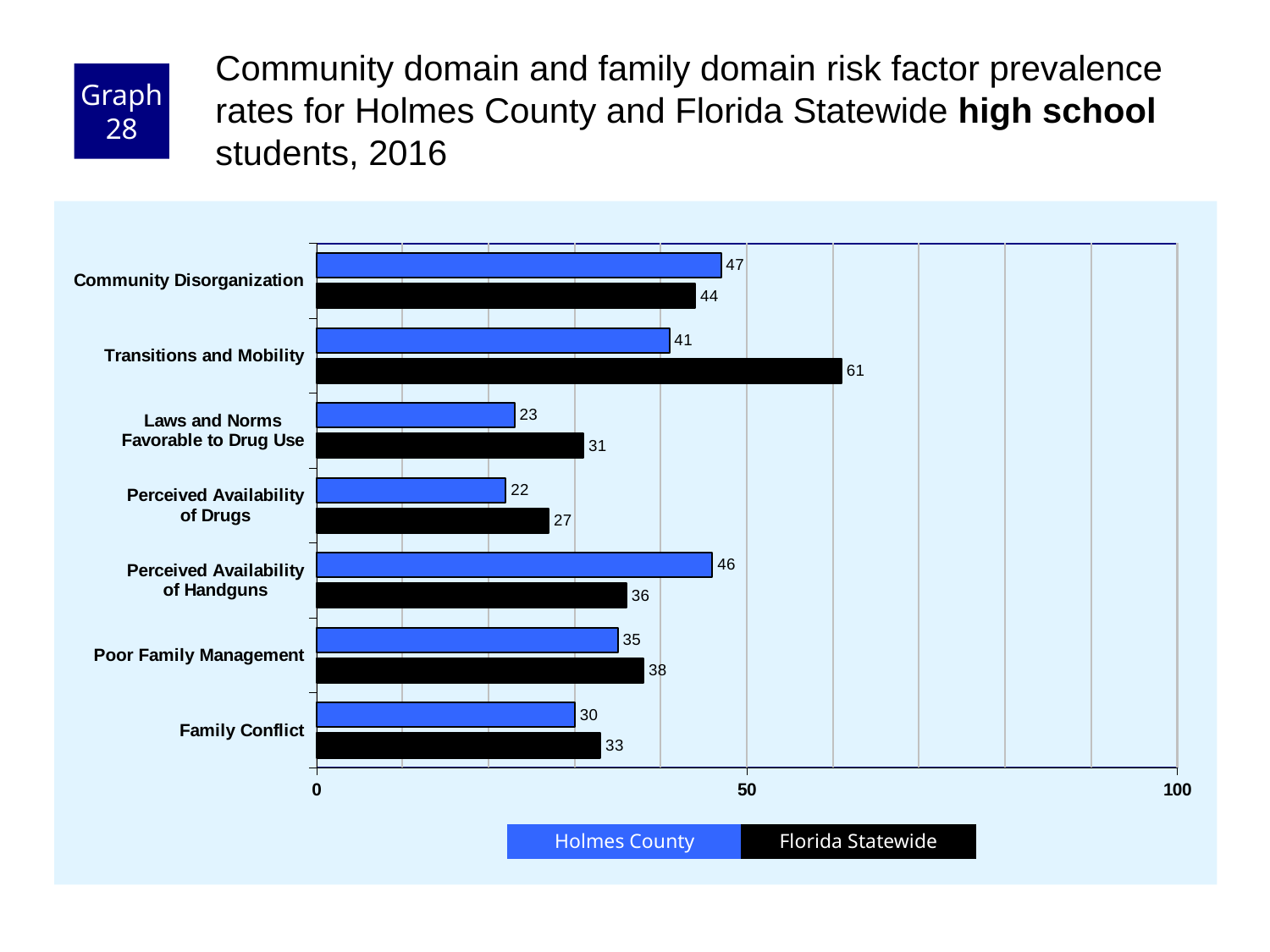
How many series does the legend list? 2 Which is larger for Perceived Availability of Handguns, the Holmes County value or the Florida Statewide value? Holmes County How many risk factor categories are shown on the chart? 7 What is the Holmes County value for Community Disorganization? 47 Which series is shown in black? Florida Statewide What kind of chart is shown on the slide? bar chart What is the difference between the Florida Statewide and Holmes County values for Transitions and Mobility? 20 Which risk factor has the lowest Holmes County value? Perceived Availability of Drugs What is the Florida Statewide value for Transitions and Mobility? 61 Which risk factor has the highest Florida Statewide value? Transitions and Mobility Is the Florida Statewide value for Transitions and Mobility greater or less than 50? greater What is the Holmes County value for Perceived Availability of Drugs? 22